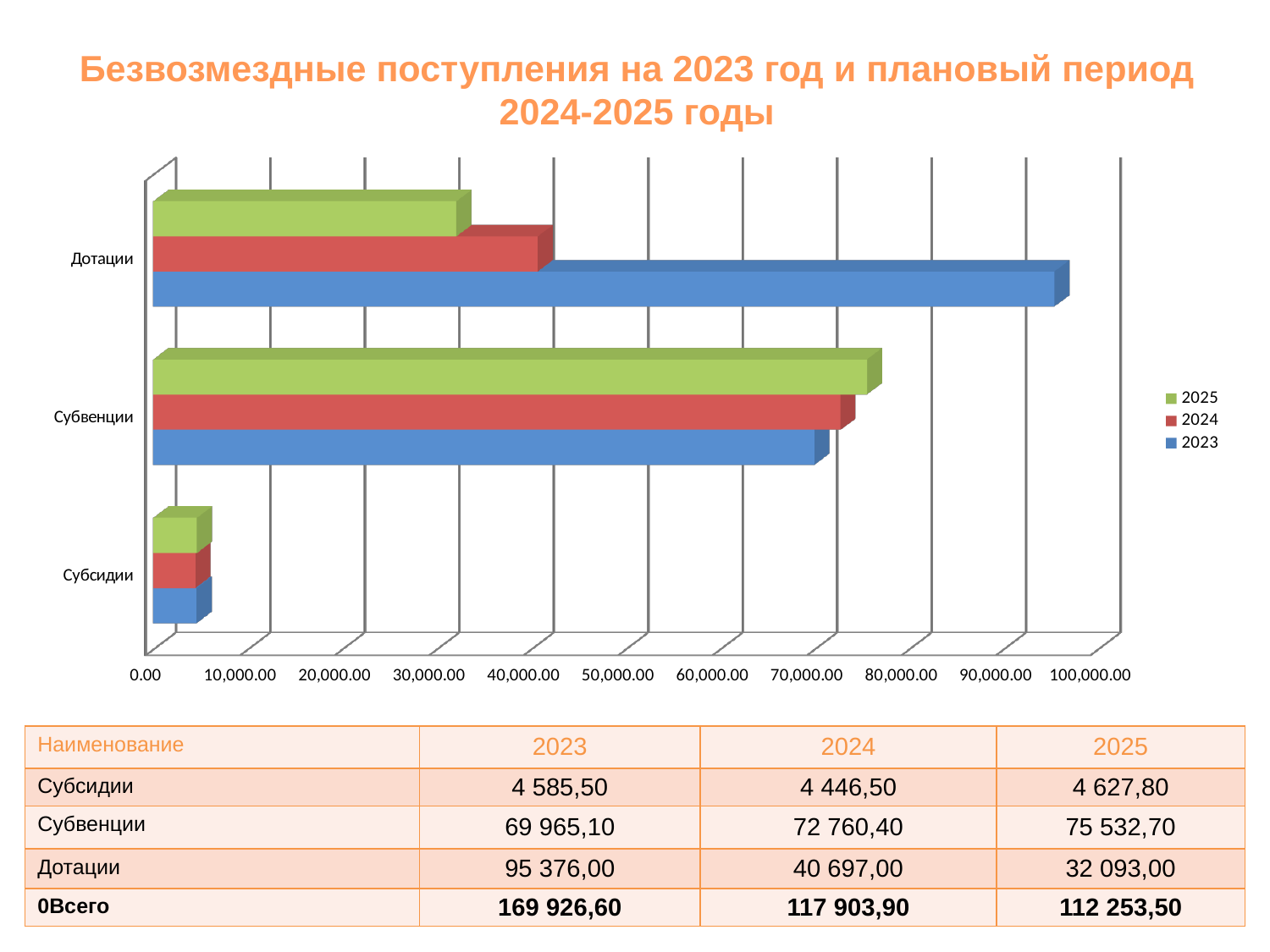
What is the difference between the Дотации values for 2023 and 2024? 54 679,00 What is the value for Субвенции in 2025? 75 532,70 What is the value for Субсидии in 2024? 4 446,50 How many categories are shown on the chart's vertical axis? 3 Which is larger for Субвенции: the 2024 value or the 2023 value? 2024 How many series does the chart legend list? 3 Which colour represents the 2025 series in the chart legend? green What is the value for Дотации in 2023? 95 376,00 Is the 2023 bar for Дотации greater or less than 90,000.00? greater Which category has the lowest value in 2025? Субсидии What kind of chart is shown on the slide? bar chart Which category has the highest value in 2023? Дотации